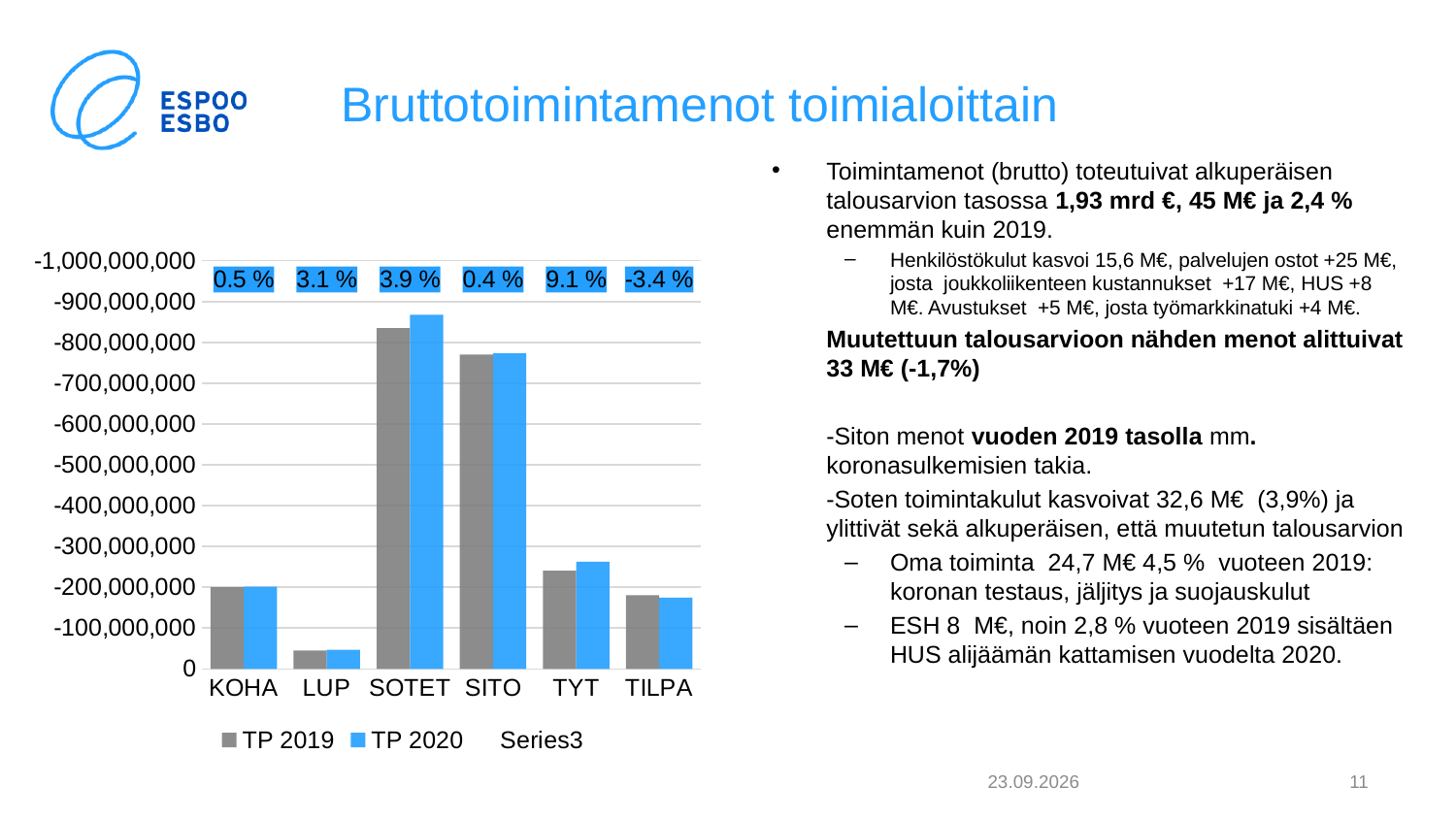
How many series does the chart legend list? 3 What is the percentage label shown above the bars for TILPA? -3.4 % Which category has the highest percentage label? TYT What is the percentage label shown above the bars for SOTET? 3.9 % Which category has the longest bars (largest expenditure) in the chart? SOTET What kind of chart is shown on the slide? bar chart What is the percentage label shown above the bars for KOHA? 0.5 % How many categories are shown on the x axis of the chart? 6 Which category has the shortest bars (smallest expenditure) in the chart? LUP Which category has the lowest percentage label? TILPA What is the percentage label shown above the bars for TYT? 9.1 % What is the title of the chart slide? Bruttotoimintamenot toimialoittain